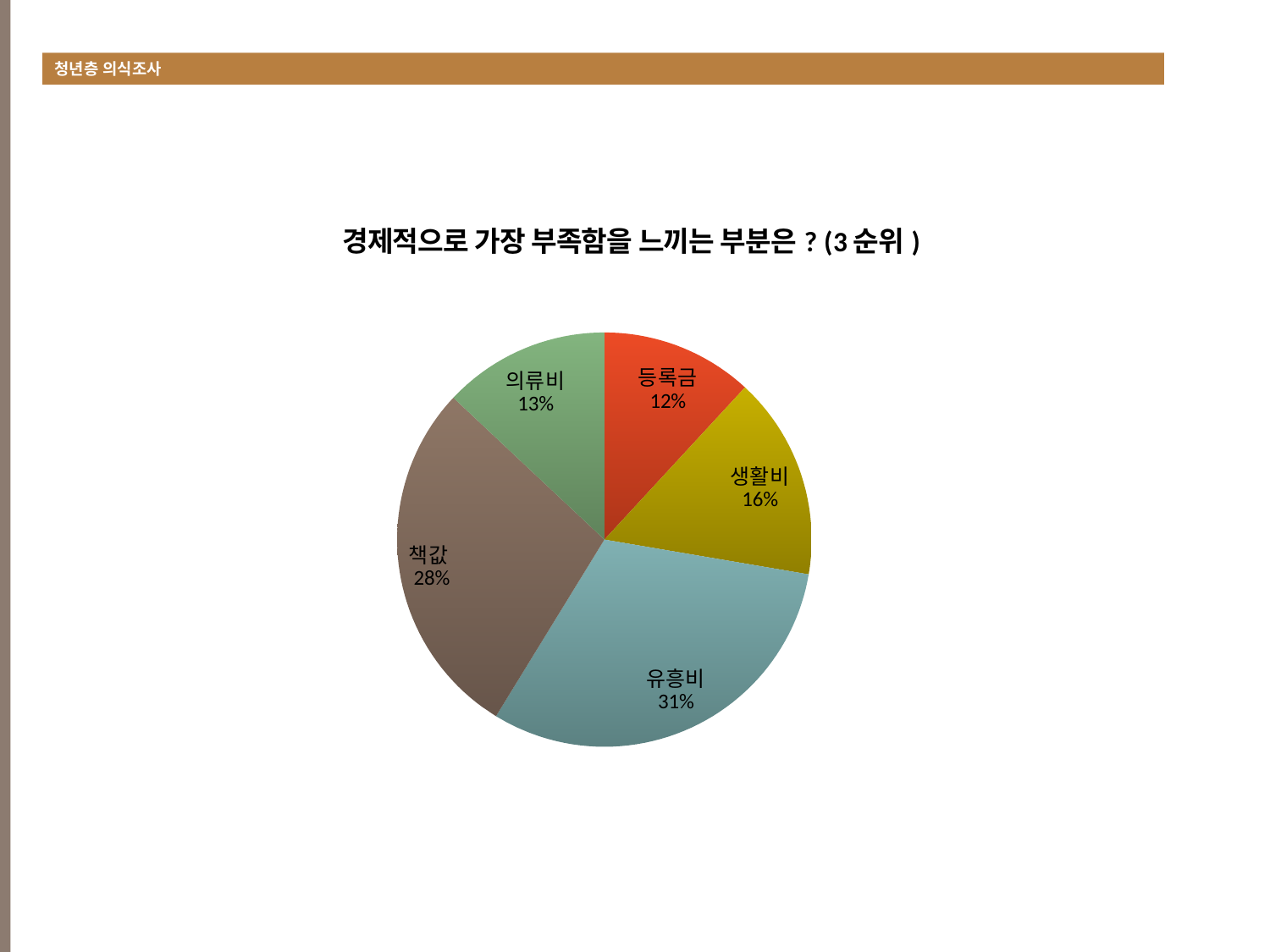
Which is larger, the share for 생활비 or the share for 의류비? 생활비 What percentage is shown for 의류비? 13% What percentage is shown for 생활비? 16% What is the title of the chart? 경제적으로 가장 부족함을 느끼는 부분은 ? (3 순위 ) What percentage is shown for 유흥비? 31% What type of chart is shown on the slide? pie chart What is the difference in percentage points between 유흥비 and 책값? 3 Which category has the smallest share of the pie? 등록금 How many categories are shown in the pie chart? 5 Which category has the largest share of the pie? 유흥비 What percentage is shown for 등록금? 12% What percentage is shown for 책값? 28%